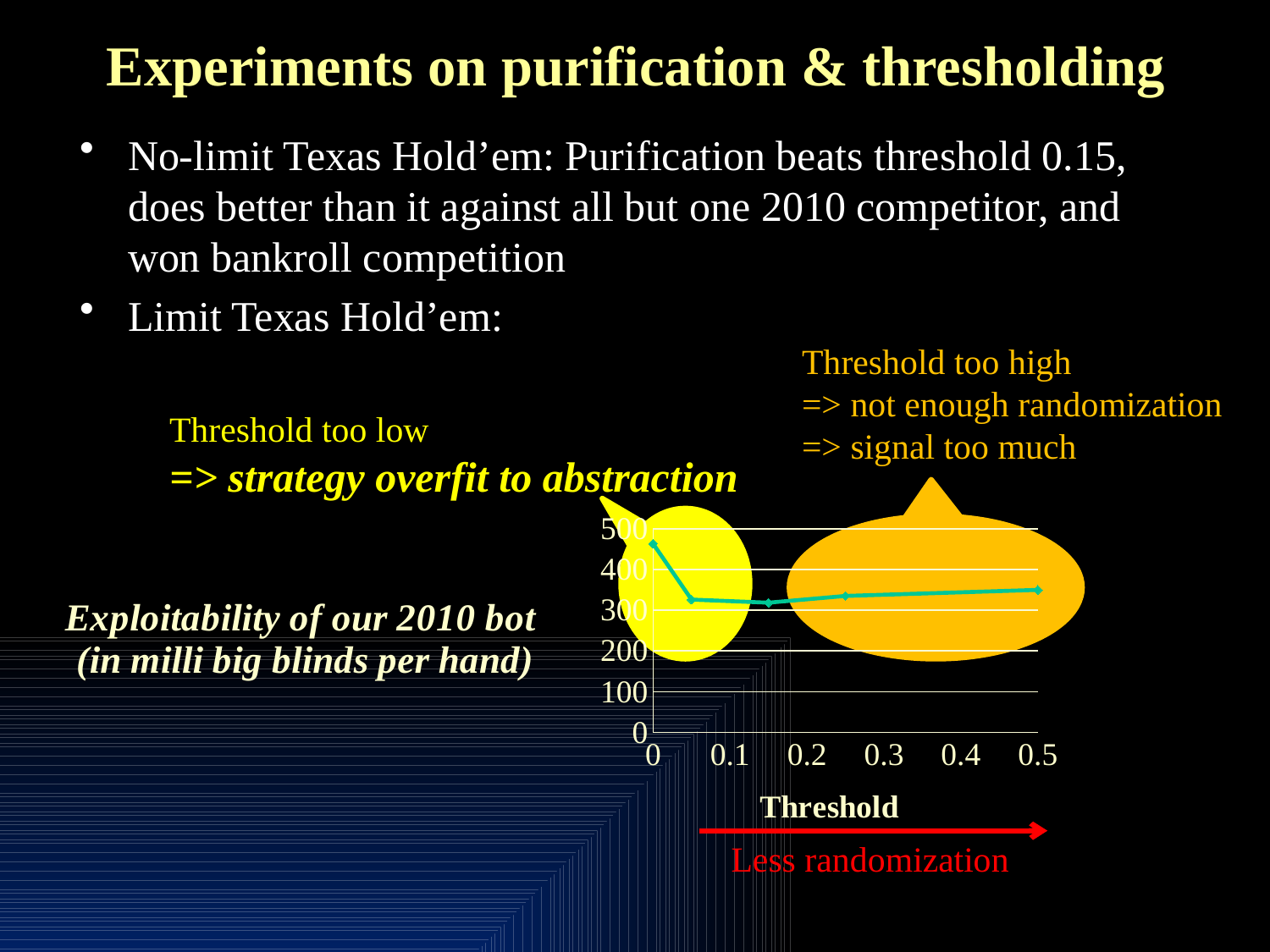
Which has the larger value: threshold 0 or threshold 0.5? threshold 0 How many data points are plotted on the line? 5 Is the value at threshold 0.5 greater or less than 300? greater What is the highest tick value shown on the y axis? 500 Is the value at threshold 0.5 greater or less than 400? less Is the value at threshold 0 greater or less than 400? greater What is the largest threshold value shown on the x axis? 0.5 Does the plotted value rise or fall between threshold 0 and threshold 0.1? fall What kind of chart is shown on the slide? line chart What is the label of the x axis of the chart? Threshold At which threshold value is the plotted exploitability highest? 0